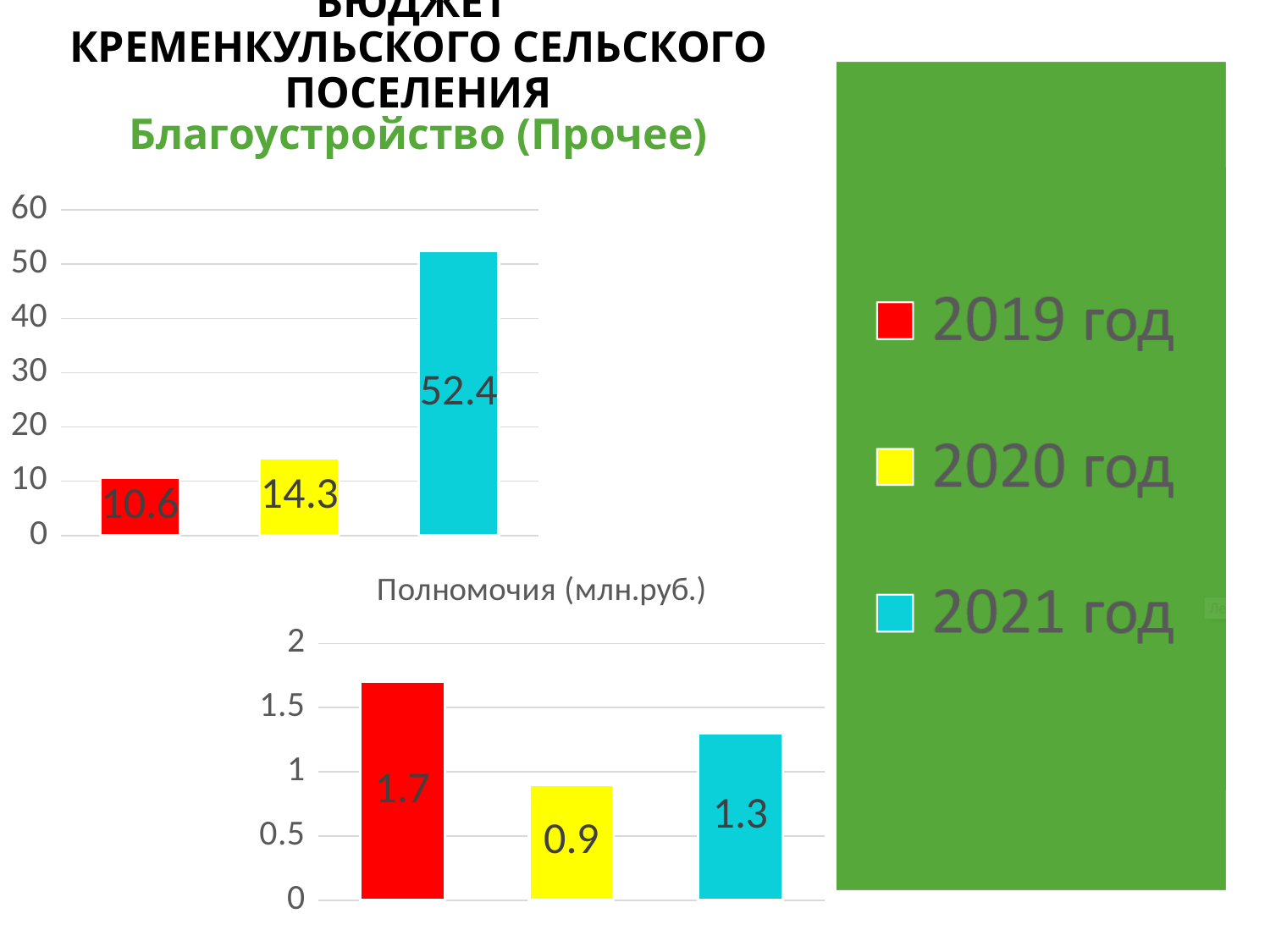
In the bottom chart (Полномочия (млн.руб.)), what is the value for 2020 год? 0.9 In the bottom chart (Полномочия (млн.руб.)), what is the value for 2021 год? 1.3 In the bottom chart (Полномочия (млн.руб.)), which is larger: the value for 2019 год or 2021 год? 2019 год What colour represents 2020 год in the legend? yellow In the top chart (Благоустройство (Прочее)), which year has the highest value? 2021 год In the bottom chart (Полномочия (млн.руб.)), which year has the lowest value? 2020 год In the top chart (Благоустройство (Прочее)), what is the difference between the values for 2021 год and 2020 год? 38.1 In the bottom chart (Полномочия (млн.руб.)), what is the difference between the values for 2019 год and 2021 год? 0.4 In the top chart (Благоустройство (Прочее)), what is the value for 2019 год? 10.6 In the top chart (Благоустройство (Прочее)), do the values rise or fall from 2019 to 2021? rise In the top chart (Благоустройство (Прочее)), what is the value for 2021 год? 52.4 How many bars are in the bottom chart (Полномочия (млн.руб.))? 3